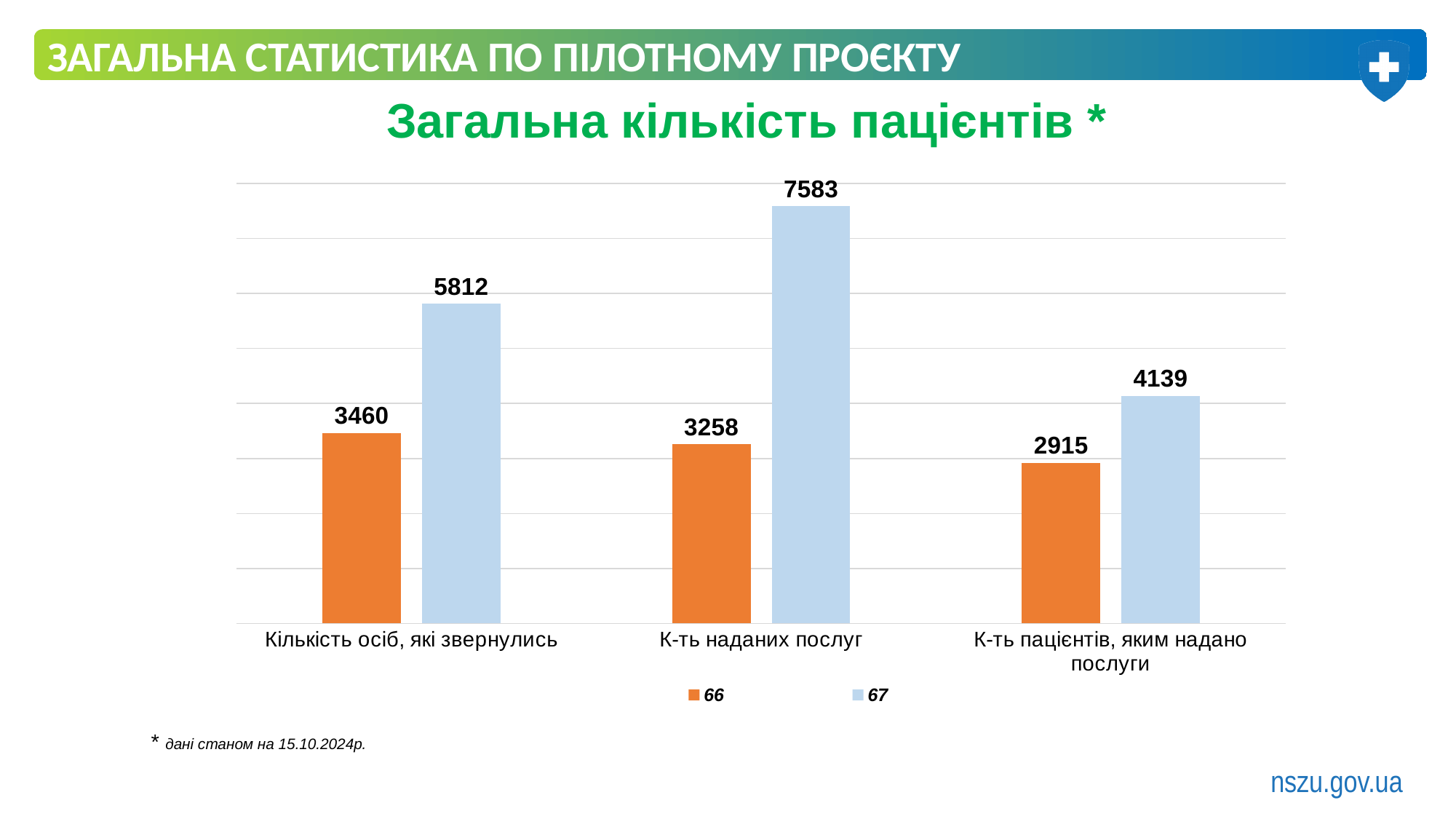
Which category has the lowest value for series 66? К-ть пацієнтів, яким надано послуги What is the difference between series 67 and series 66 in the category "Кількість осіб, які звернулись"? 2352 What is the difference between series 67 and series 66 in the category "К-ть наданих послуг"? 4325 What is the value for series 67 in the category "К-ть пацієнтів, яким надано послуги"? 4139 Which category has the highest value for series 67? К-ть наданих послуг Which is larger: series 66 for "Кількість осіб, які звернулись" or series 66 for "К-ть наданих послуг"? Кількість осіб, які звернулись How many series does the legend list? 2 What kind of chart is shown on the slide? Bar chart What is the value for series 67 in the category "К-ть наданих послуг"? 7583 How many categories are shown on the x axis? 3 What is the value for series 66 in the category "К-ть пацієнтів, яким надано послуги"? 2915 What is the value for series 66 in the category "Кількість осіб, які звернулись"? 3460